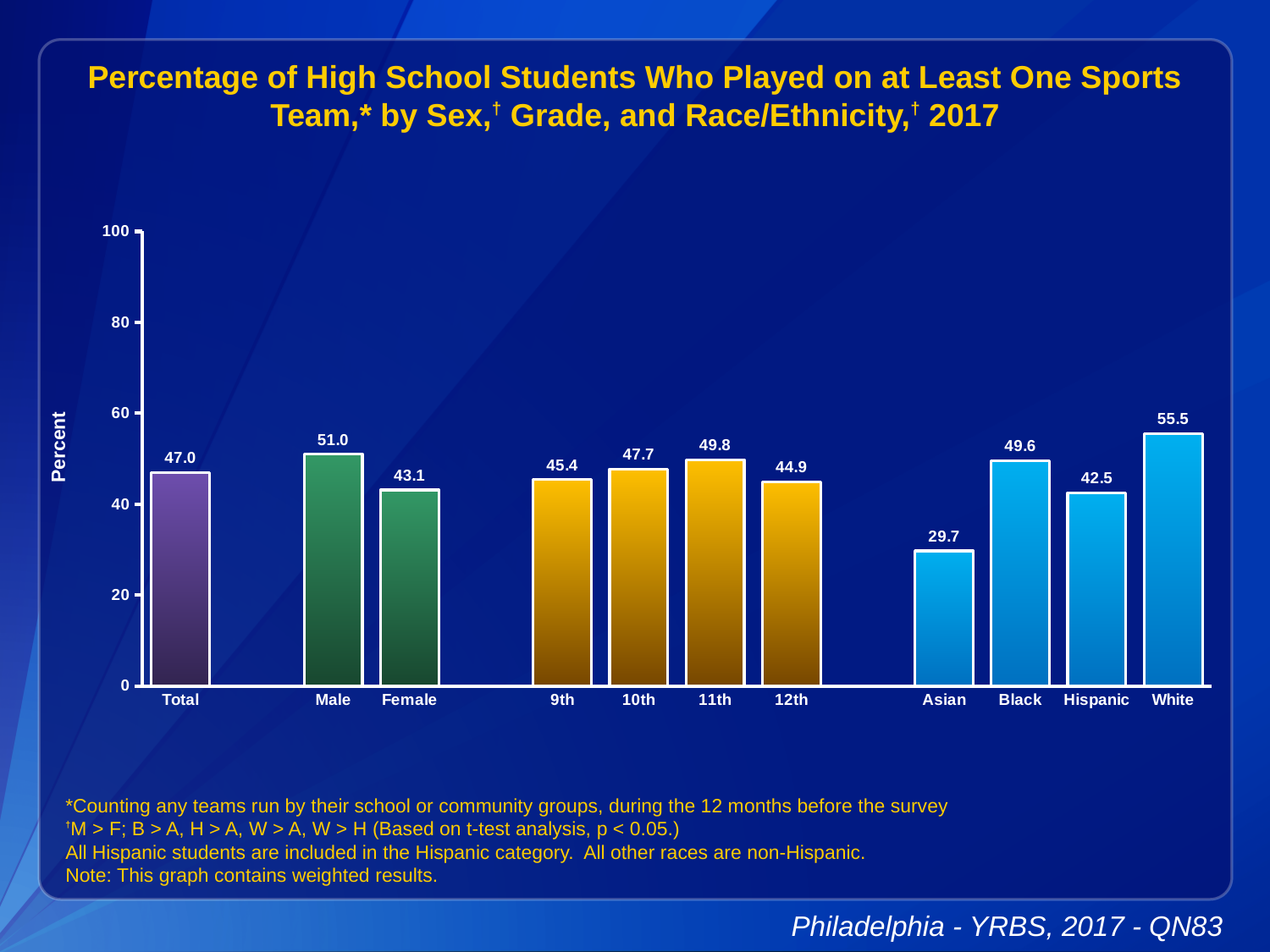
Which is larger, the value for 11th grade or 12th grade? 11th Is the value for Hispanic students greater or less than 40? greater What is the value for Total? 47.0 What is the difference between the Male and Female values? 7.9 What is the difference between the White and Black values? 5.9 What kind of chart is shown on the slide? bar chart What is the value for Asian students? 29.7 Which category has the lowest value? Asian What percentage of Male students played on at least one sports team? 51.0 What is the label of the y axis? Percent How many bars are shown in the chart? 11 Which category has the highest value? White